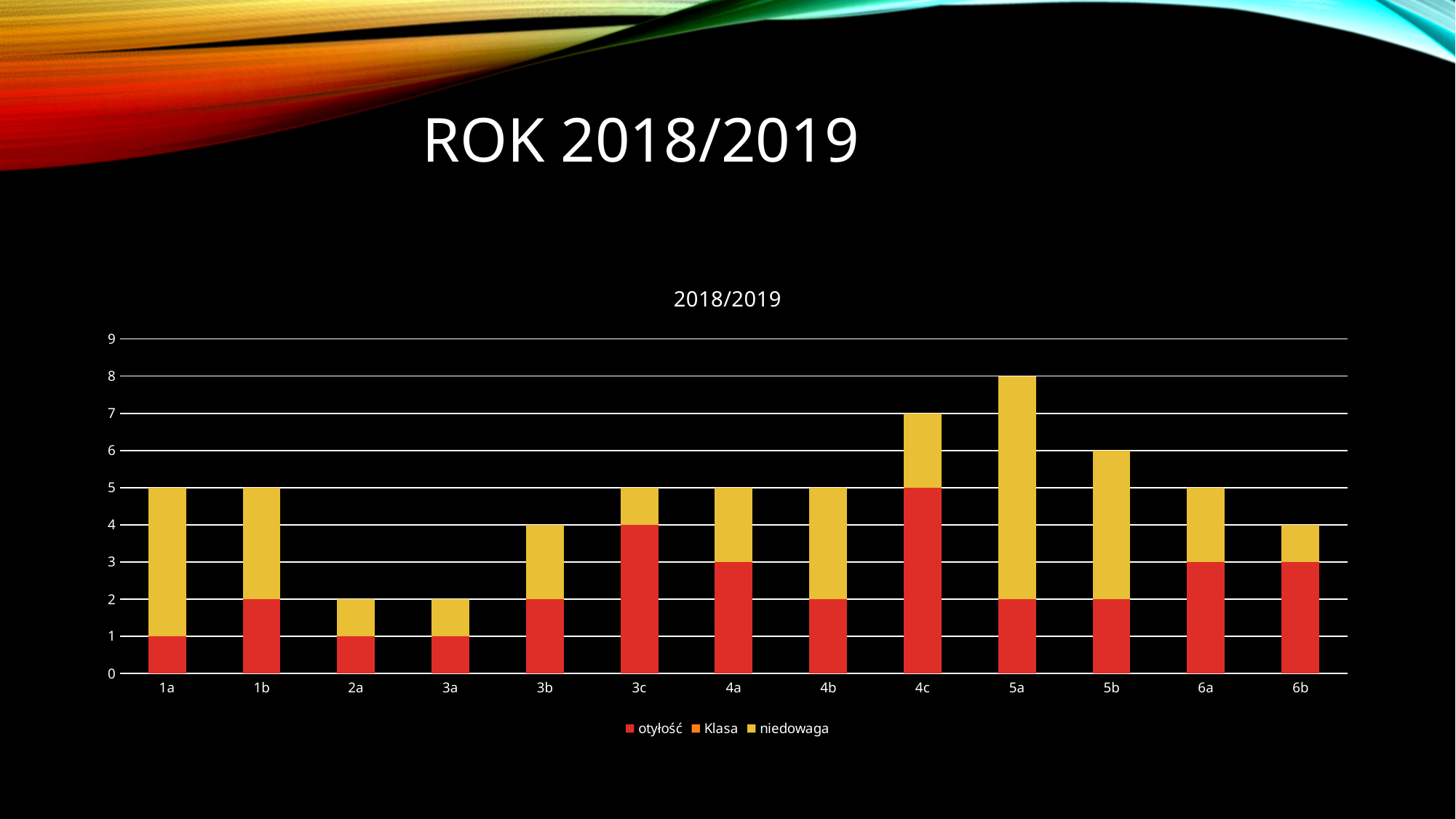
What is the difference between the total stacked bar for class 5a and the total for class 2a? 6 What is the otyłość value for class 4c? 5 How many series does the chart legend list? 3 What is the otyłość value for class 3c? 4 Which class has the highest otyłość value? 4c Which class has the tallest stacked bar in the chart? 5a What is the total height of the stacked bar for class 4c? 7 What is the title of the chart? 2018/2019 What is the total height of the stacked bar for class 5a? 8 How many classes (categories) are shown on the x axis of the chart? 13 Which is larger, the total stacked bar for class 5b or for class 6b? 5b What kind of chart is shown on the slide? stacked bar chart